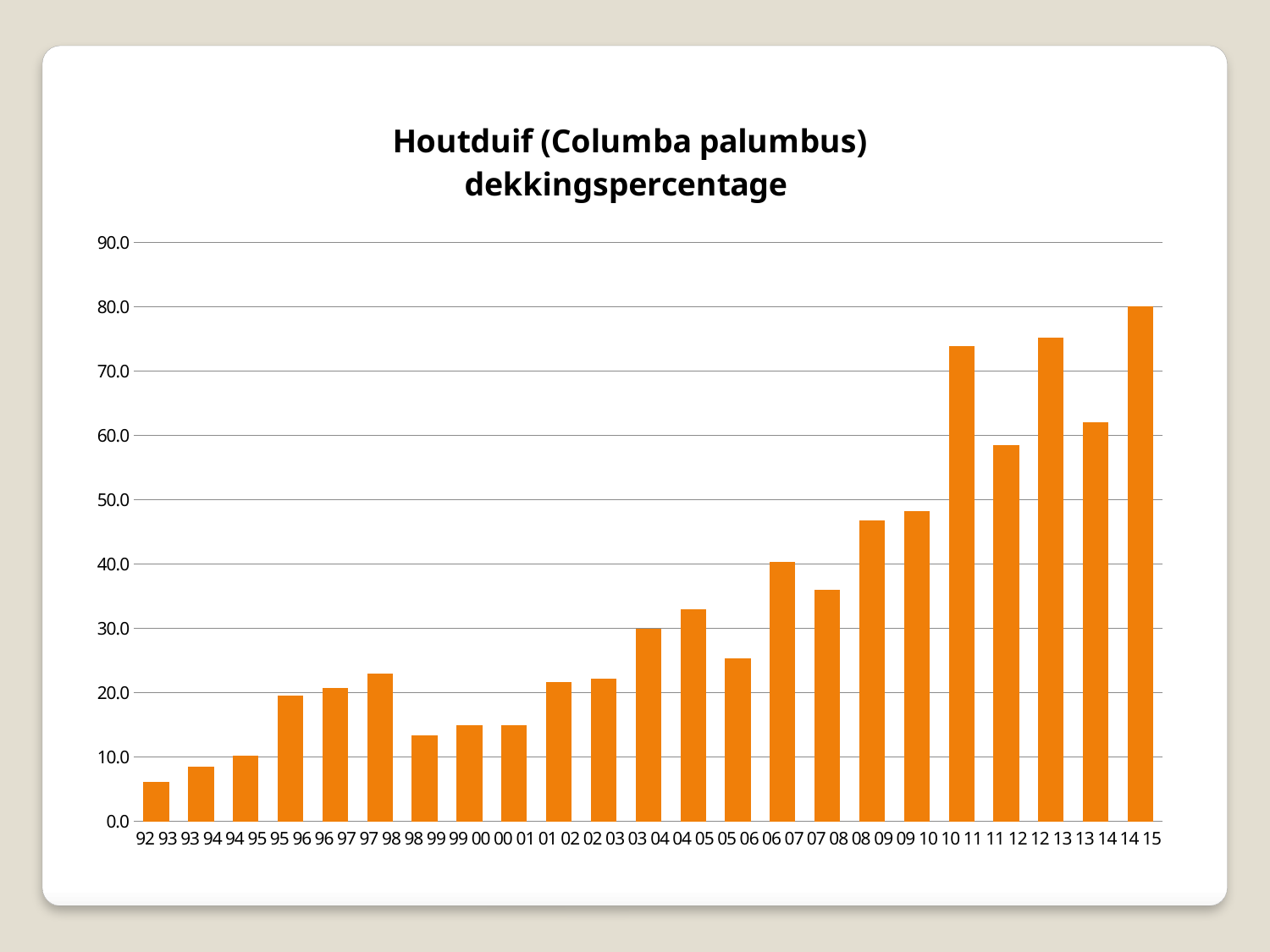
What is the title of the chart? Houtduif (Columba palumbus) dekkingspercentage Do the values generally rise or fall from 92 93 to 14 15? rise Is the value for 11 12 greater or less than 60? less Is the value for 10 11 greater or less than 70? greater Which season has the highest value? 14 15 Which is larger, the value for 05 06 or the value for 04 05? 04 05 What kind of chart is shown on the slide? bar chart Is the value for 98 99 greater or less than 20? less Which is larger, the value for 10 11 or the value for 11 12? 10 11 Which season has the lowest value? 92 93 How many bars (seasons) are plotted in the chart? 23